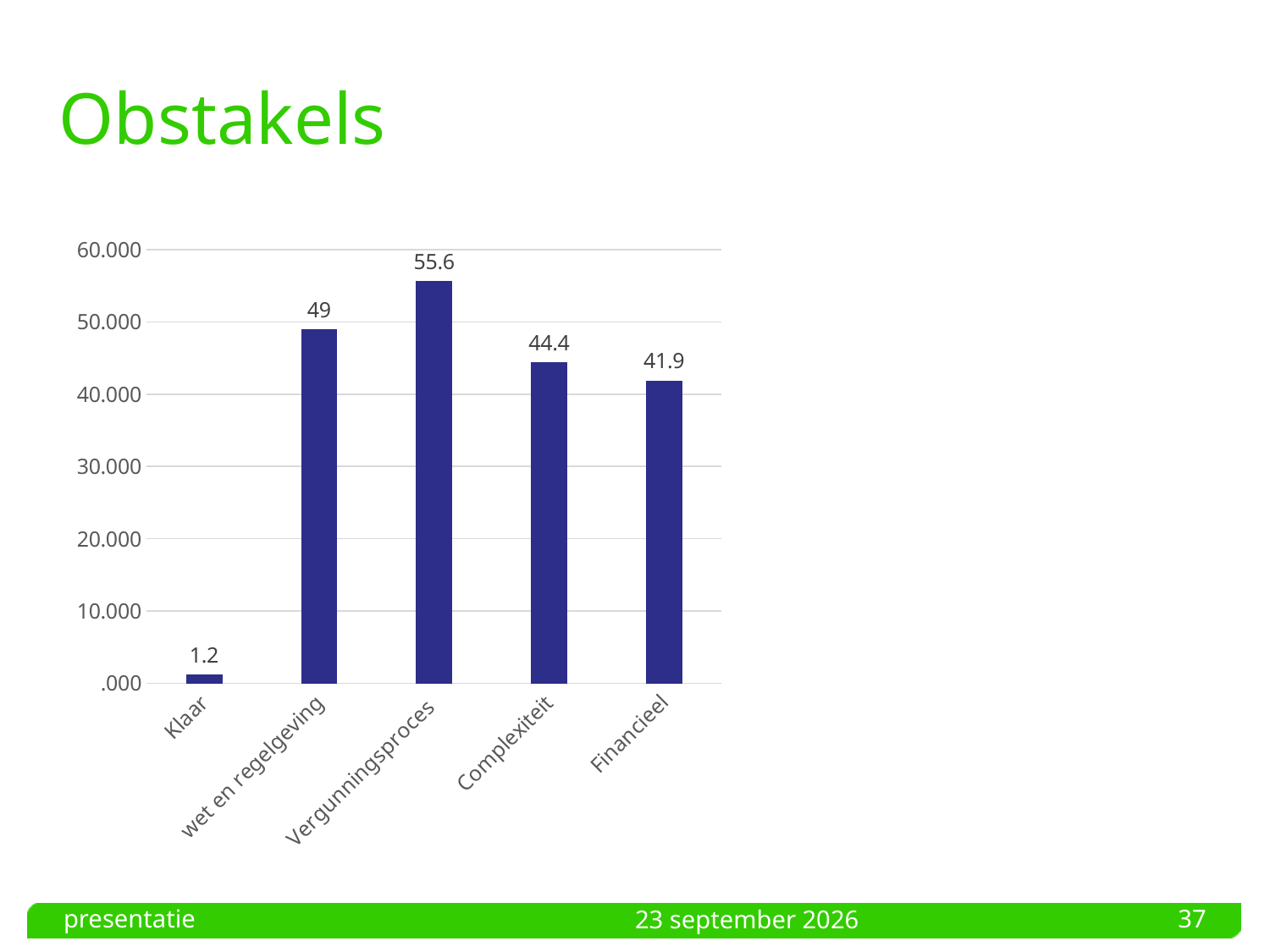
What is the value for Vergunningsproces? 55.6 What is the difference between the values for Vergunningsproces and Complexiteit? 11.2 What kind of chart is shown on the slide? bar chart Which category has the lowest value? Klaar What is the difference between the values for wet en regelgeving and Financieel? 7.1 What is the value for wet en regelgeving? 49 Which is larger, the value for Complexiteit or the value for Financieel? Complexiteit What is the value for Financieel? 41.9 What is the value for Klaar? 1.2 What is the title of the slide containing the chart? Obstakels How many categories are shown on the x axis? 5 Which category has the highest value? Vergunningsproces